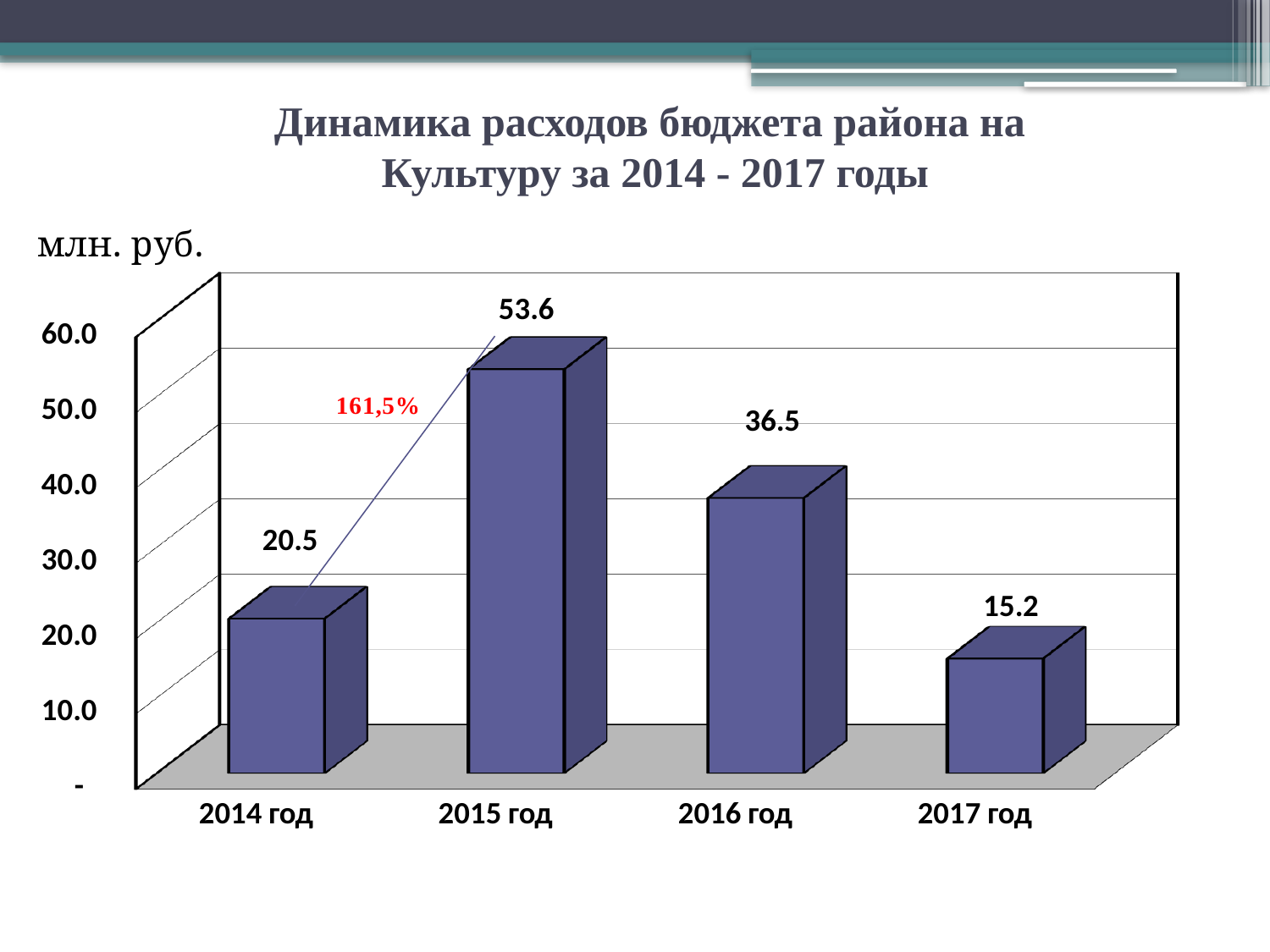
What is the value for 2015 год? 53.6 What unit is indicated above the chart's vertical axis? млн. руб. Which is larger, the value for 2016 год or the value for 2014 год? 2016 год Is the value for 2016 год greater or less than 40.0? less What kind of chart is shown on the slide? bar chart How many years are shown on the chart? 4 What is the value for 2014 год? 20.5 What is the difference between the values for 2014 год and 2017 год? 5.3 Which year has the lowest value? 2017 год Which year has the highest value? 2015 год What is the difference between the values for 2015 год and 2016 год? 17.1 What is the value for 2017 год? 15.2